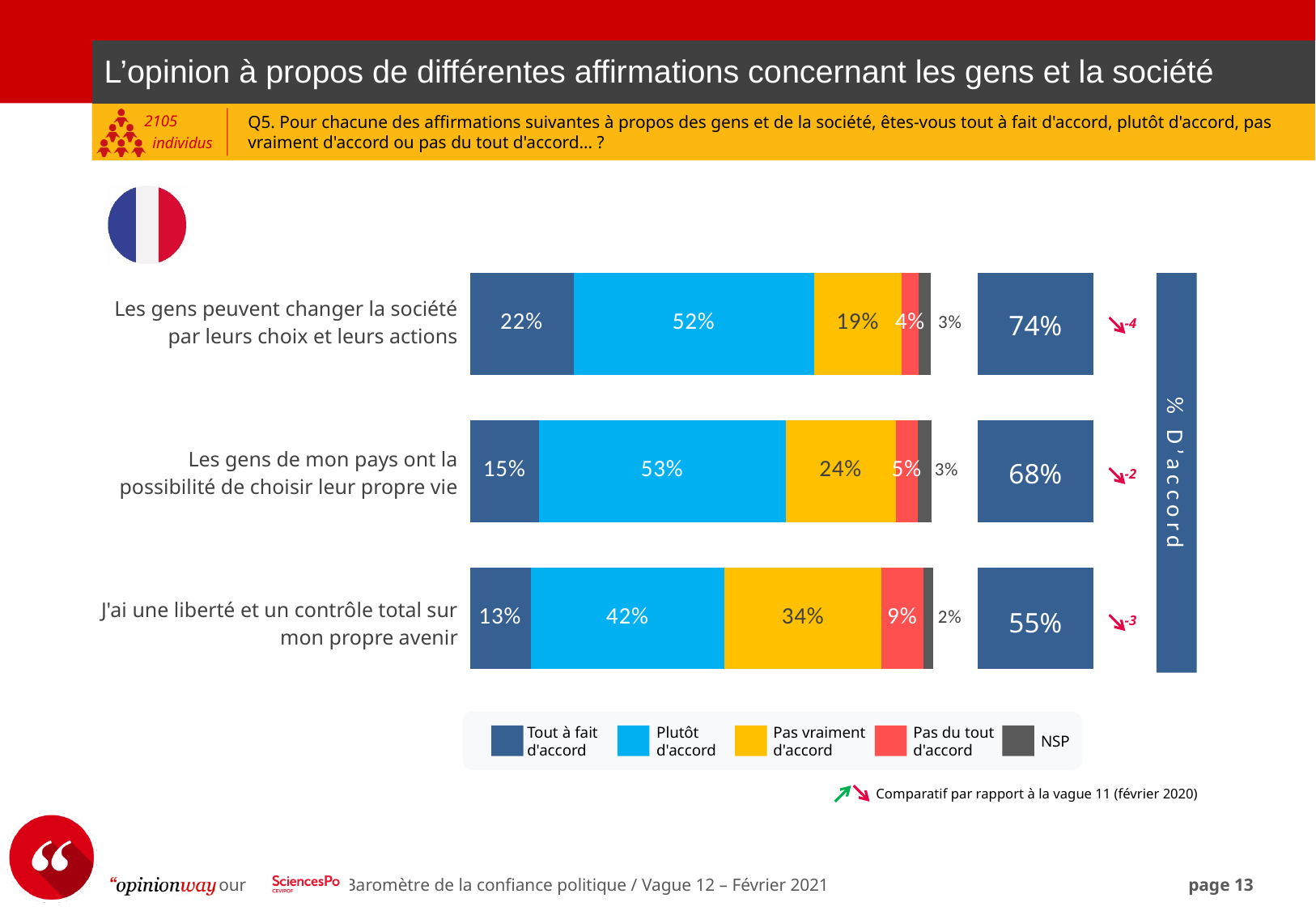
What percentage answered "Plutôt d'accord" to "Les gens de mon pays ont la possibilité de choisir leur propre vie"? 53% How many response categories does the legend list? 5 How many statements are plotted in the chart? 3 Which statement has the lowest "Tout à fait d'accord" share? J'ai une liberté et un contrôle total sur mon propre avenir What percentage answered "Pas du tout d'accord" to "J'ai une liberté et un contrôle total sur mon propre avenir"? 9% What is the change versus wave 11 shown next to the 74% "% D'accord" value? -4 What kind of chart is shown on the slide? Stacked bar chart What percentage of respondents answered "Tout à fait d'accord" to "Les gens peuvent changer la société par leurs choix et leurs actions"? 22% What is the difference between the "% D'accord" totals for "Les gens peuvent changer la société par leurs choix et leurs actions" and "Les gens de mon pays ont la possibilité de choisir leur propre vie"? 6 percentage points Which statement has the highest "% D'accord" total? Les gens peuvent changer la société par leurs choix et leurs actions Which is larger: the "Pas vraiment d'accord" share for "J'ai une liberté et un contrôle total sur mon propre avenir" or for "Les gens de mon pays ont la possibilité de choisir leur propre vie"? J'ai une liberté et un contrôle total sur mon propre avenir What is the total "% D'accord" shown for "J'ai une liberté et un contrôle total sur mon propre avenir"? 55%